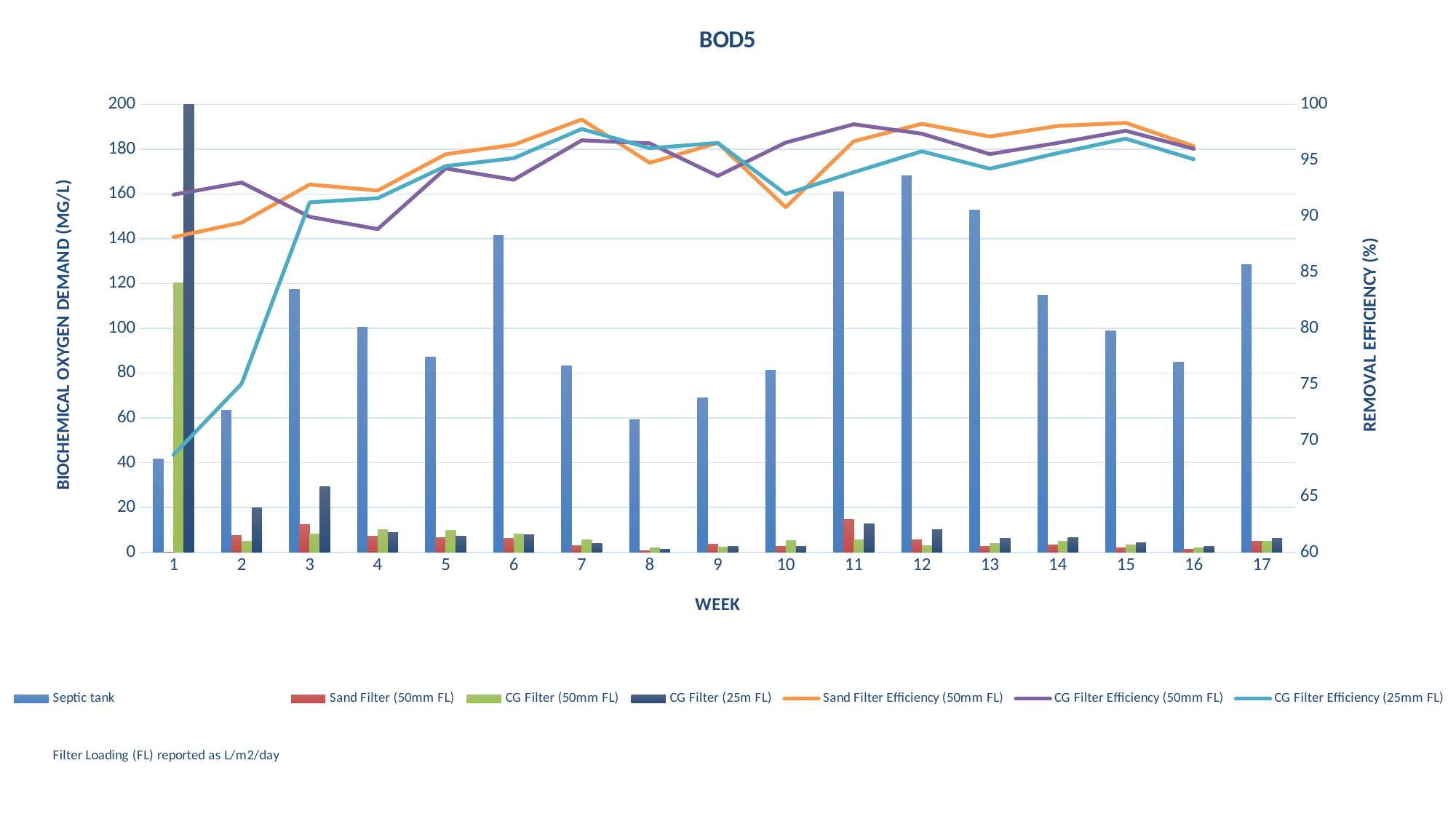
In which week is the Septic tank value highest? Week 12 Which is larger, the Septic tank value in week 3 or in week 4? Week 3 Does the CG Filter Efficiency (25mm FL) line rise or fall from week 1 to week 7? rise How many series does the legend list? 7 What kind of chart is shown on the slide? A combined bar and line chart How many weeks are plotted along the x axis? 17 Is the Septic tank value in week 3 greater or less than 100? greater What is the title of the chart? BOD5 In which week is the Septic tank value lowest? Week 1 Is the Septic tank value in week 13 greater or less than 140? greater Is the Sand Filter Efficiency (50mm FL) in week 1 greater or less than 90? less